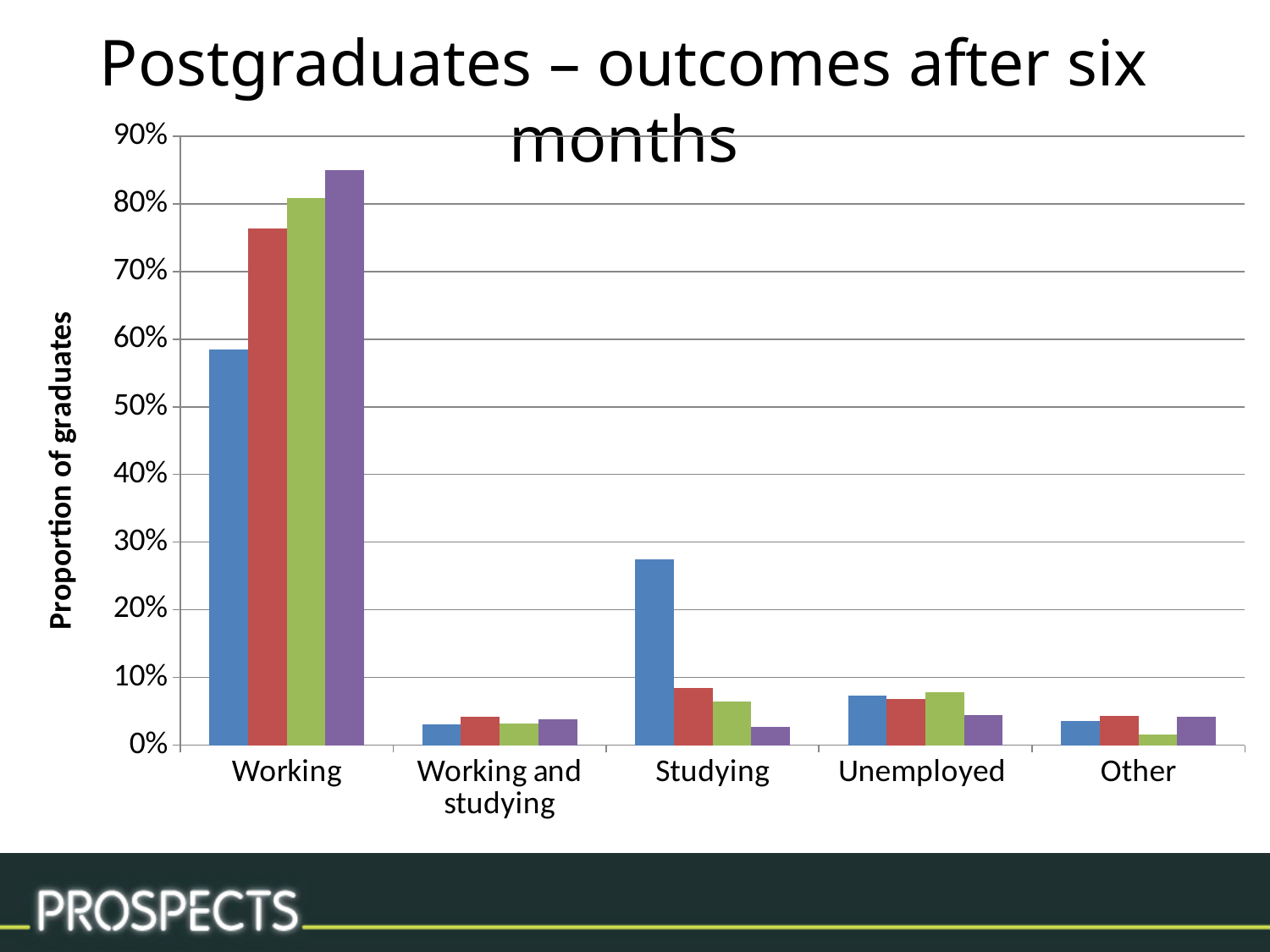
What is the label on the vertical axis of the chart? Proportion of graduates Within the Working category, which coloured bar is the tallest? purple Is the value of the purple bar for Working greater or less than 80%? greater Which is larger: the blue bar for Studying or the blue bar for Unemployed? the blue bar for Studying Is the value of the blue bar for Working greater or less than 50%? greater Is the value of the red bar for Working greater or less than 70%? greater Within the Studying category, which coloured bar is the tallest? blue How many categories are shown on the x axis of the chart? 5 Which category has the tallest bars in the chart? Working What kind of chart is shown on the slide? bar chart